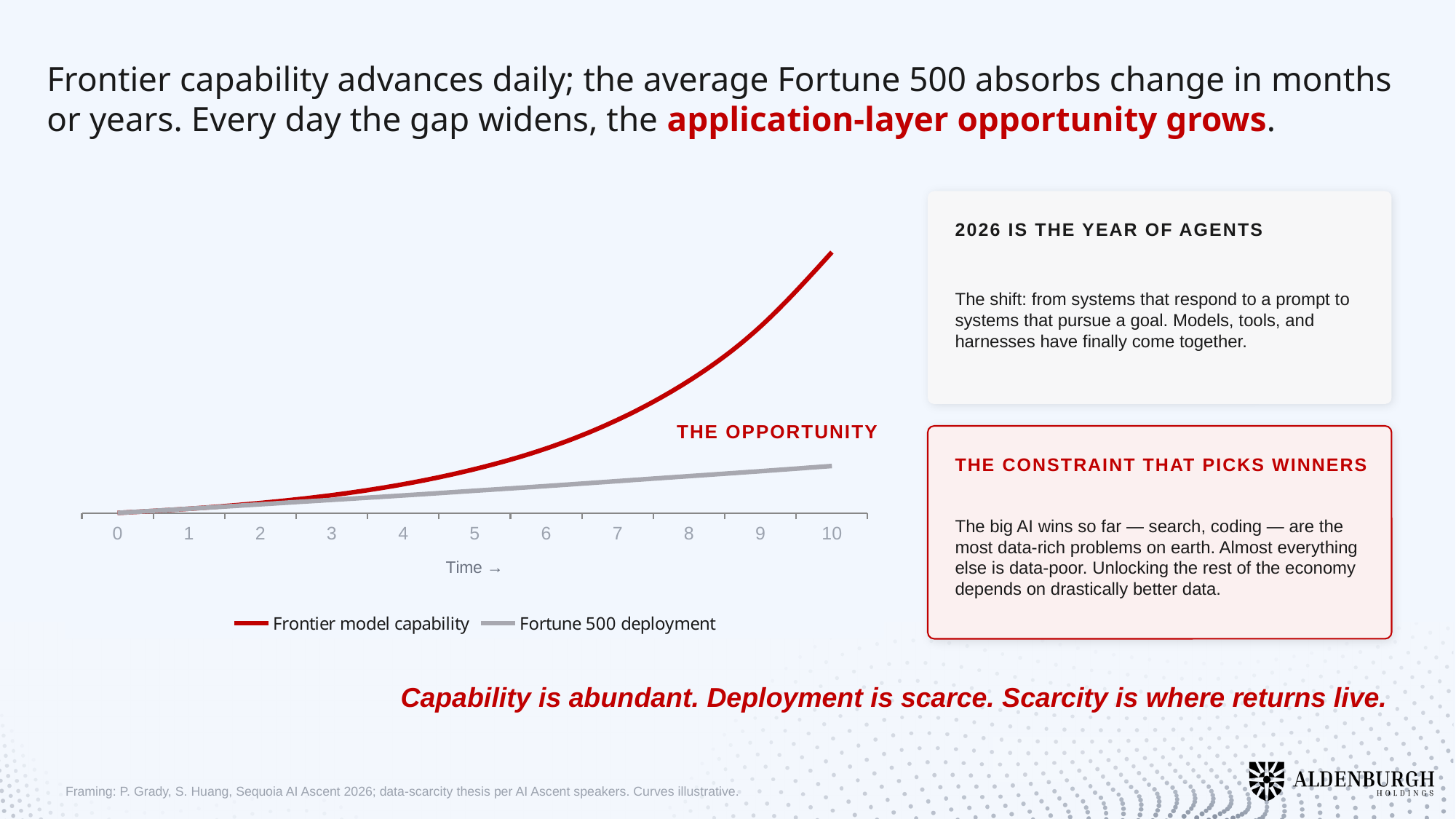
What kind of chart is shown on the slide? line chart How many series does the chart legend list? 2 What are the two series named in the chart legend? Frontier model capability and Fortune 500 deployment Which series reaches the highest point on the chart? Frontier model capability What is the label on the chart's x axis? Time → At time 10, which series is higher: Frontier model capability or Fortune 500 deployment? Frontier model capability What is the first tick label on the x axis of the chart? 0 How many tick labels are shown along the x axis of the chart? 11 Does the Fortune 500 deployment line rise or fall as time increases? rises Does the Frontier model capability line rise or fall as time increases? rises Which series has the lower value at time 10? Fortune 500 deployment What is the last tick label on the x axis of the chart? 10